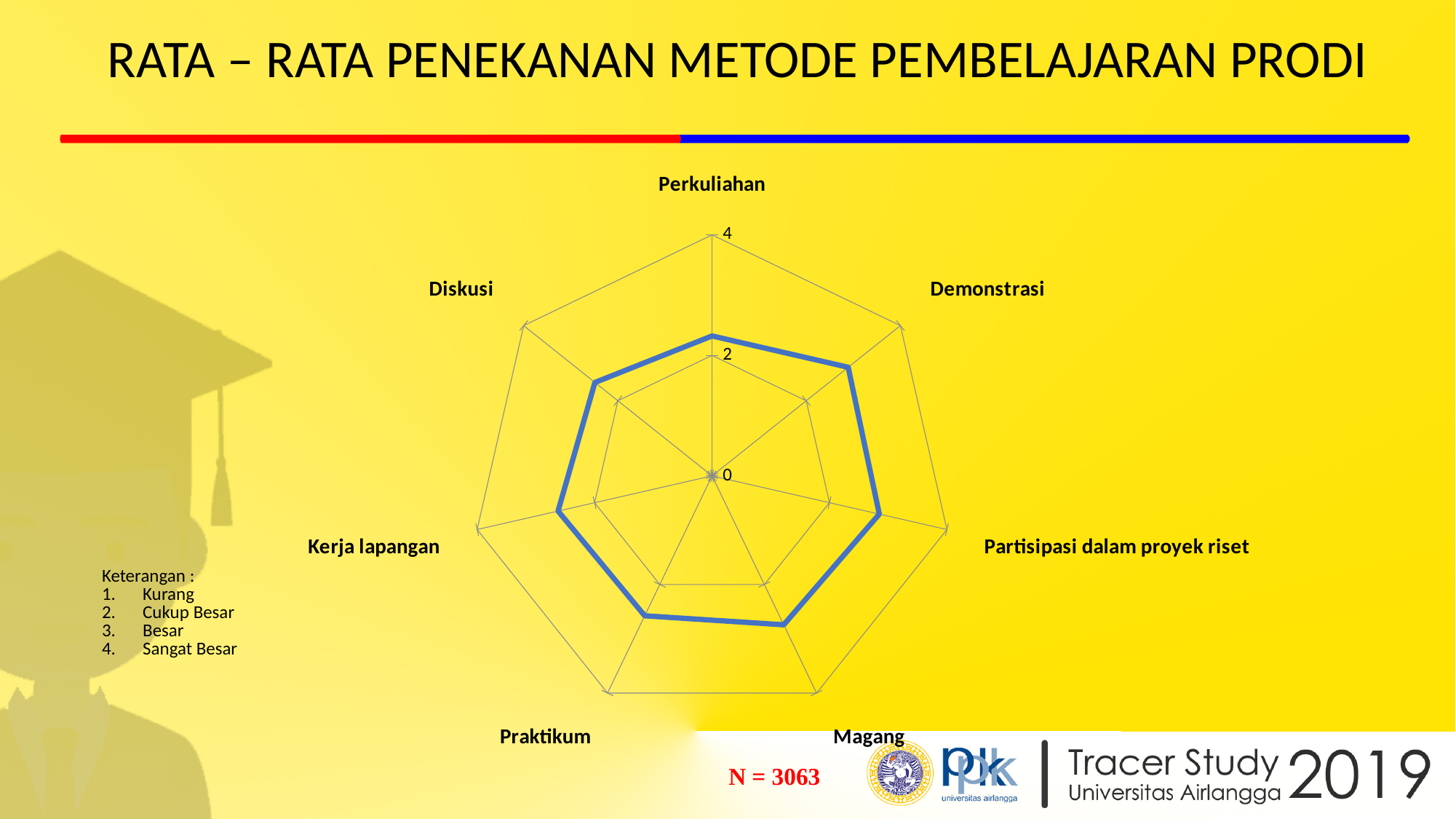
Which is larger, the value for Demonstrasi or the value for Perkuliahan? Demonstrasi How many categories (learning methods) are plotted on the radar chart? 7 Is the value for Partisipasi dalam proyek riset greater or less than 4? less Is the value for Diskusi greater or less than 2? greater Is the value for Magang greater or less than 4? less Which is larger, the value for Partisipasi dalam proyek riset or the value for Perkuliahan? Partisipasi dalam proyek riset What is the sample size (N) stated on the slide? N = 3063 What kind of chart is shown on the slide? radar chart What is the maximum value shown on the radar chart's axis? 4 Which category has the lowest value on the radar chart? Perkuliahan